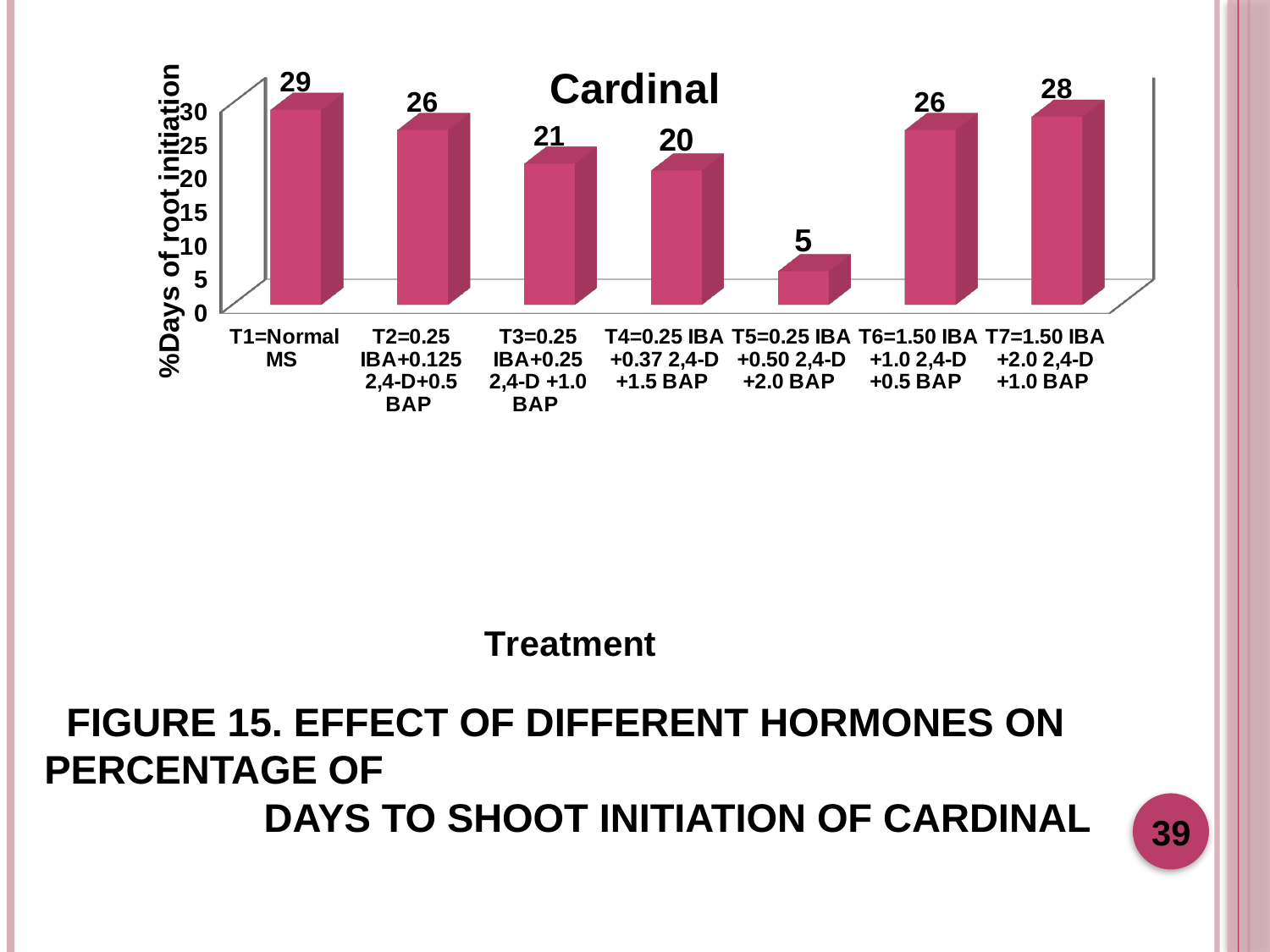
How many treatments are shown on the chart? 7 What is the label of the vertical axis? %Days of root initiation What is the difference between the values for T1=Normal MS and T5=0.25 IBA +0.50 2,4-D +2.0 BAP? 24 Which is larger, the value for T3=0.25 IBA+0.25 2,4-D +1.0 BAP or the value for T4=0.25 IBA +0.37 2,4-D +1.5 BAP? T3=0.25 IBA+0.25 2,4-D +1.0 BAP Which treatment has the highest value? T1=Normal MS What is the difference between the values for T7=1.50 IBA +2.0 2,4-D +1.0 BAP and T4=0.25 IBA +0.37 2,4-D +1.5 BAP? 8 What is the value for T5=0.25 IBA +0.50 2,4-D +2.0 BAP? 5 What kind of chart is shown on the slide? Bar chart What is the value for T7=1.50 IBA +2.0 2,4-D +1.0 BAP? 28 What is the title of the chart? Cardinal Which treatment has the lowest value? T5=0.25 IBA +0.50 2,4-D +2.0 BAP What is the value for T1=Normal MS? 29